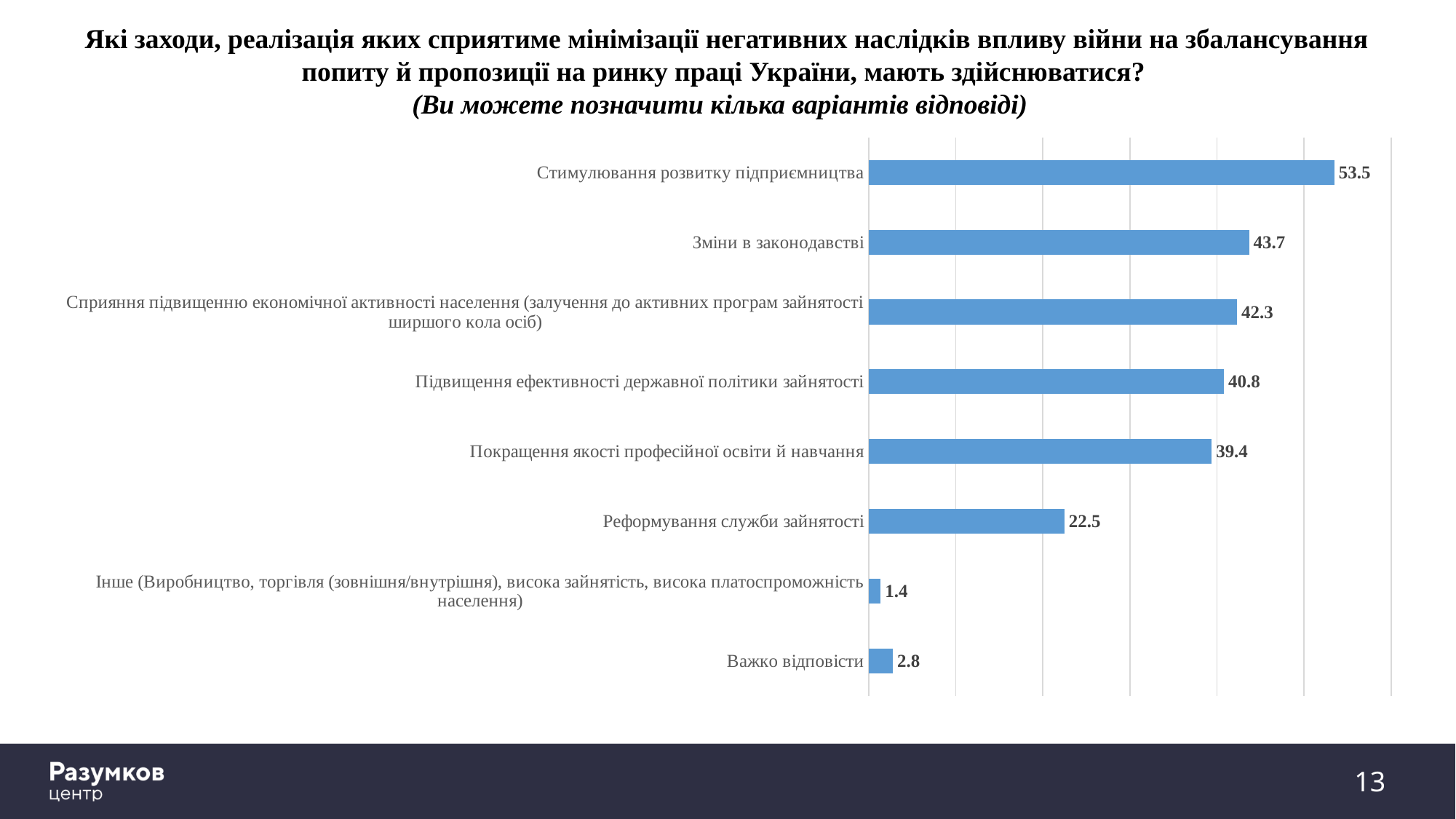
Which is larger: the value for "Важко відповісти" or the value for "Інше"? Важко відповісти What value is shown for "Стимулювання розвитку підприємництва"? 53.5 What is the difference between the values for "Підвищення ефективності державної політики зайнятості" and "Покращення якості професійної освіти й навчання"? 1.4 What type of chart is shown on the slide? Bar chart What value is shown for "Важко відповісти"? 2.8 Which category has the highest value? Стимулювання розвитку підприємництва Which category has the lowest value? Інше (Виробництво, торгівля (зовнішня/внутрішня), висока зайнятість, висока платоспроможність населення) What is the difference between the values for "Стимулювання розвитку підприємництва" and "Зміни в законодавстві"? 9.8 What value is shown for "Зміни в законодавстві"? 43.7 How many categories are shown in the chart? 8 Which is larger: the value for "Сприяння підвищенню економічної активності населення" or the value for "Реформування служби зайнятості"? Сприяння підвищенню економічної активності населення What value is shown for "Реформування служби зайнятості"? 22.5